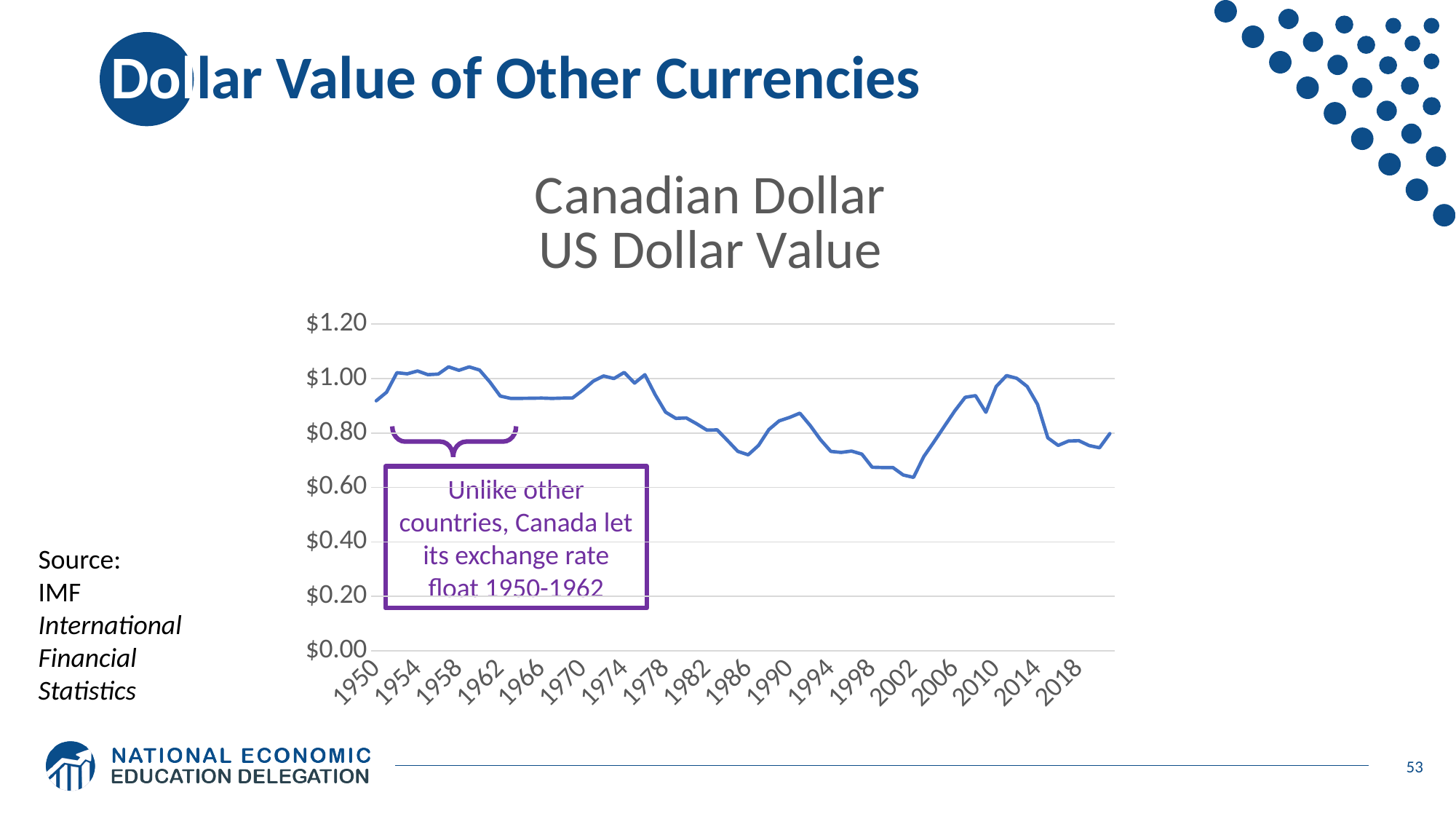
Is the value for 1986 greater or less than $0.80? less How many year labels are shown along the x axis of the chart? 18 What is the highest value shown on the vertical axis of the chart? $1.20 Is the value for 2002 greater or less than $0.80? less Is the value for 1958 greater or less than $1.00? greater What kind of chart is shown on the slide? line chart Does the value rise or fall between 2002 and 2010? rise Does the value rise or fall between 1974 and 1986? fall What is the title of the chart? Canadian Dollar US Dollar Value Which year has the larger value, 1958 or 2002? 1958